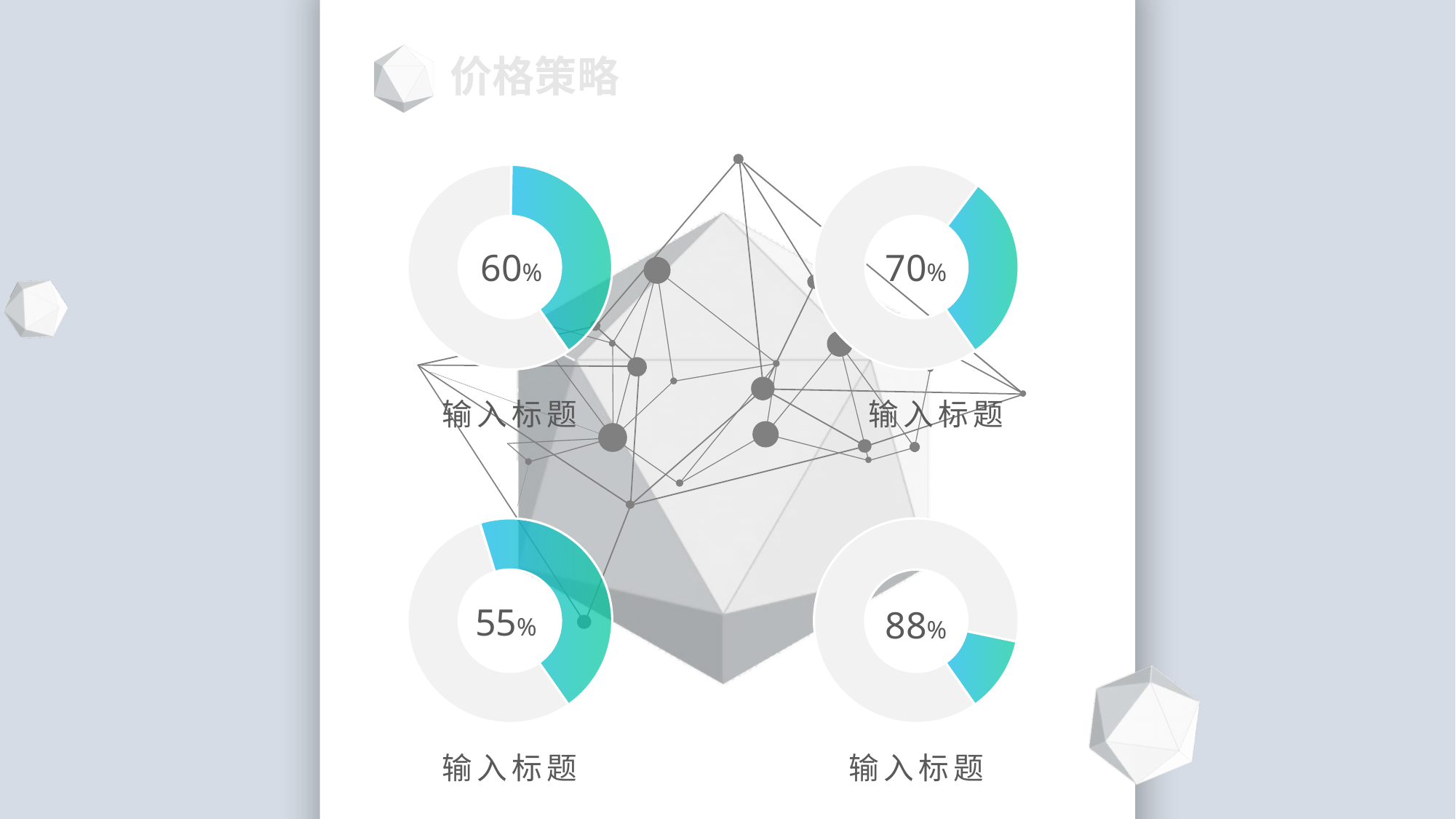
Which of the four donut charts shows the lowest printed percentage? The bottom-left chart (55%) What kind of chart is used to display the percentages on this slide? Donut (pie) chart What value is printed in the centre of the top-left donut chart? 60% What value is printed in the centre of the bottom-right donut chart? 88% Which shows a larger printed percentage, the top-left donut chart or the top-right donut chart? The top-right chart Which of the four donut charts shows the highest printed percentage? The bottom-right chart (88%) What value is printed in the centre of the top-right donut chart? 70% What value is printed in the centre of the bottom-left donut chart? 55% What is the difference between the percentage printed in the bottom-right donut chart and the one in the bottom-left donut chart? 33 percentage points What is the title of the slide? 价格策略 What is the difference between the percentage printed in the top-right donut chart and the one in the top-left donut chart? 10 percentage points How many donut charts are shown on the slide? 4